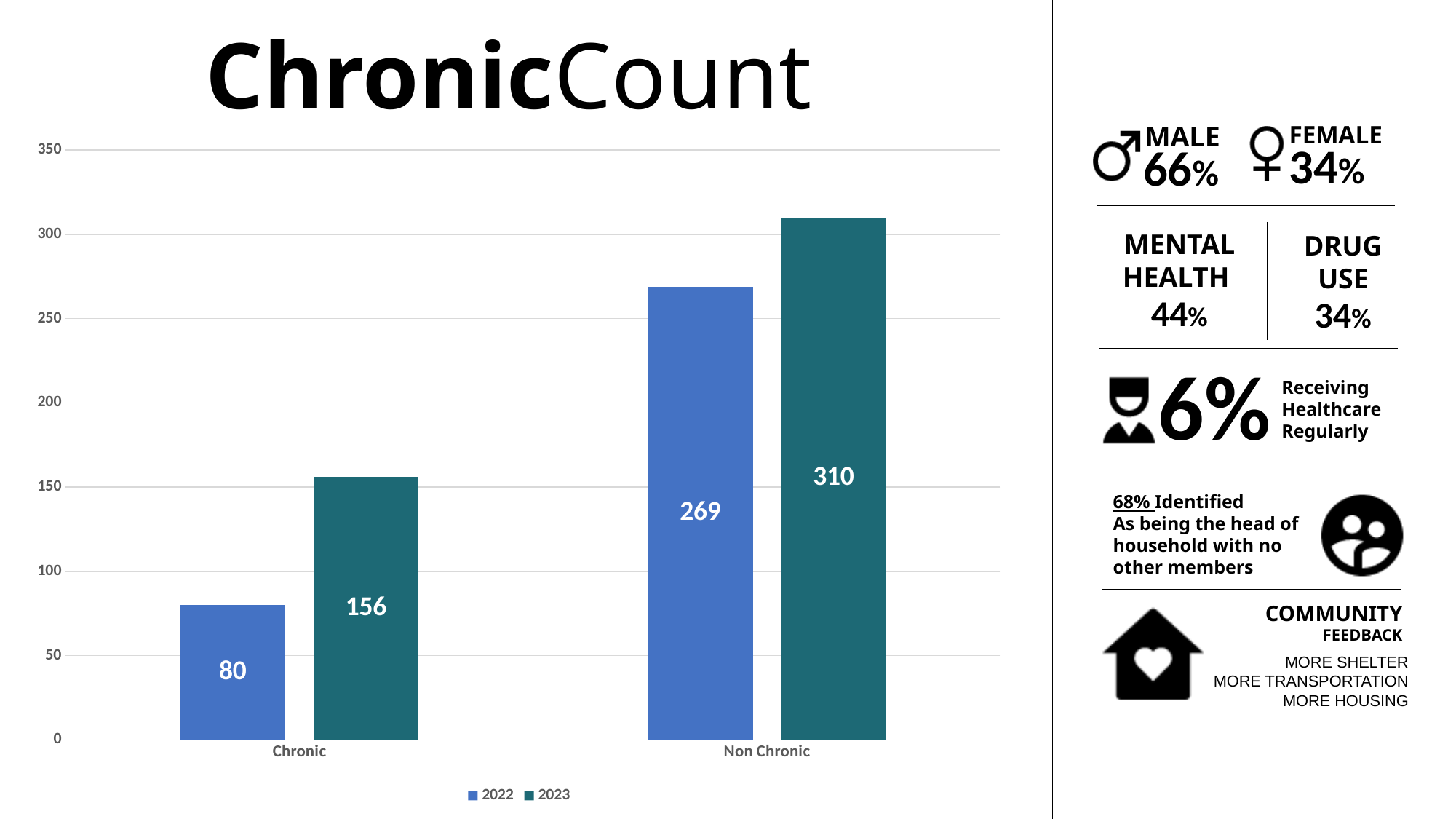
What is the value for Non Chronic in 2022? 269 How many series does the legend list? 2 How many categories are shown on the x axis? 2 What kind of chart is shown on the slide? Bar chart What is the difference between the 2023 and 2022 values for Non Chronic? 41 What is the value for Chronic in 2022? 80 Which bar has the highest value on the chart? Non Chronic, 2023 What is the difference between the 2023 and 2022 values for Chronic? 76 Which bar has the lowest value on the chart? Chronic, 2022 Which is larger, the 2022 value for Non Chronic or the 2023 value for Chronic? 2022 value for Non Chronic What is the value for Non Chronic in 2023? 310 What is the value for Chronic in 2023? 156